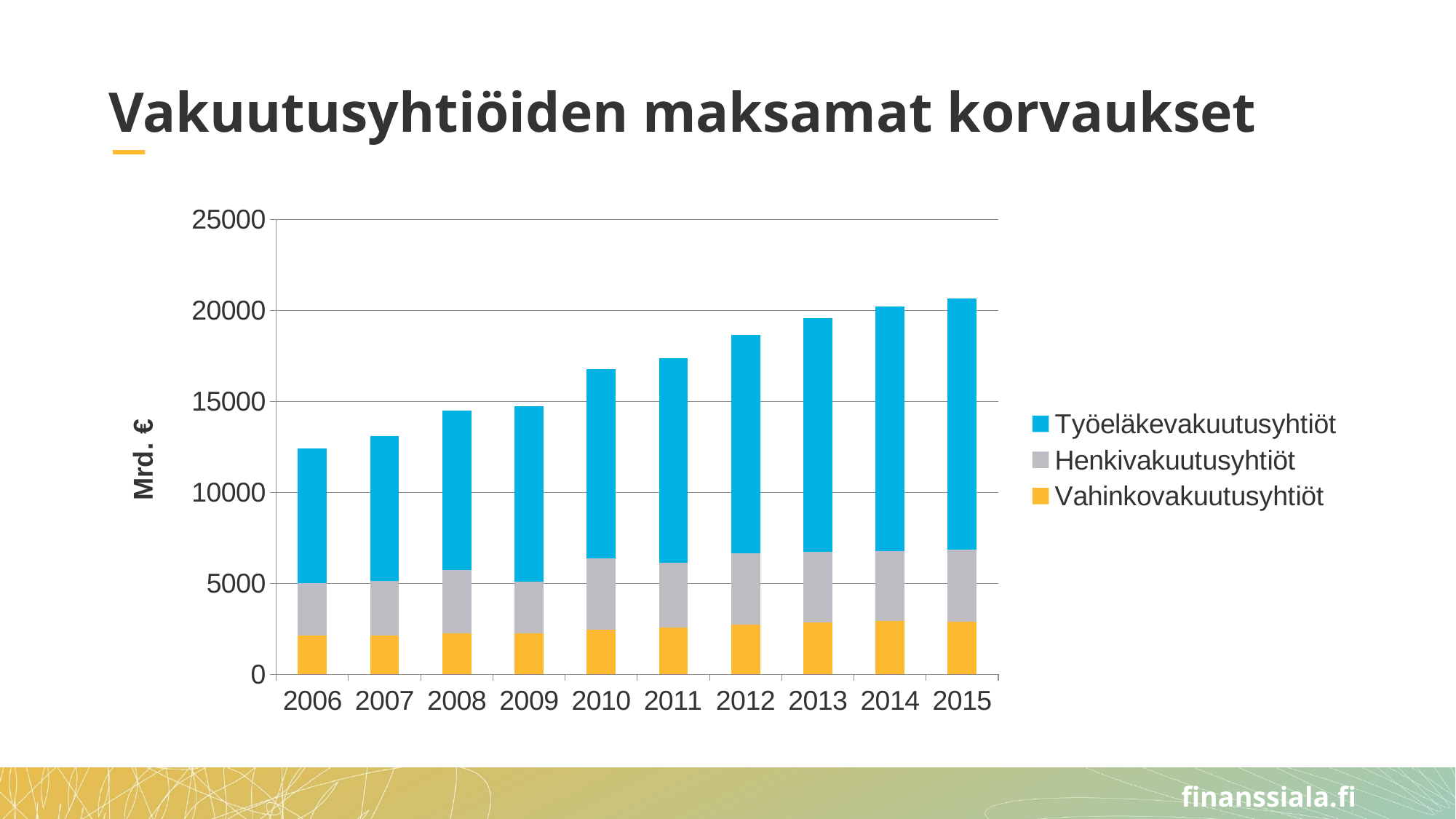
What is the label on the vertical axis of the chart? Mrd. € How many years are shown on the x axis of the chart? 10 What kind of chart is shown on the slide? Stacked bar chart Do the total bar heights generally rise or fall from 2006 to 2015? Rise Is the total value for 2006 greater or less than 15000? less Is the total value for 2015 greater or less than 20000? greater How many series does the legend list? 3 Which series forms the largest part of the 2015 bar? Työeläkevakuutusyhtiöt Which year has the lowest total bar? 2006 What is the title of the chart on the slide? Vakuutusyhtiöiden maksamat korvaukset Which year has the highest total bar? 2015 Is the total value for 2013 greater or less than 20000? less